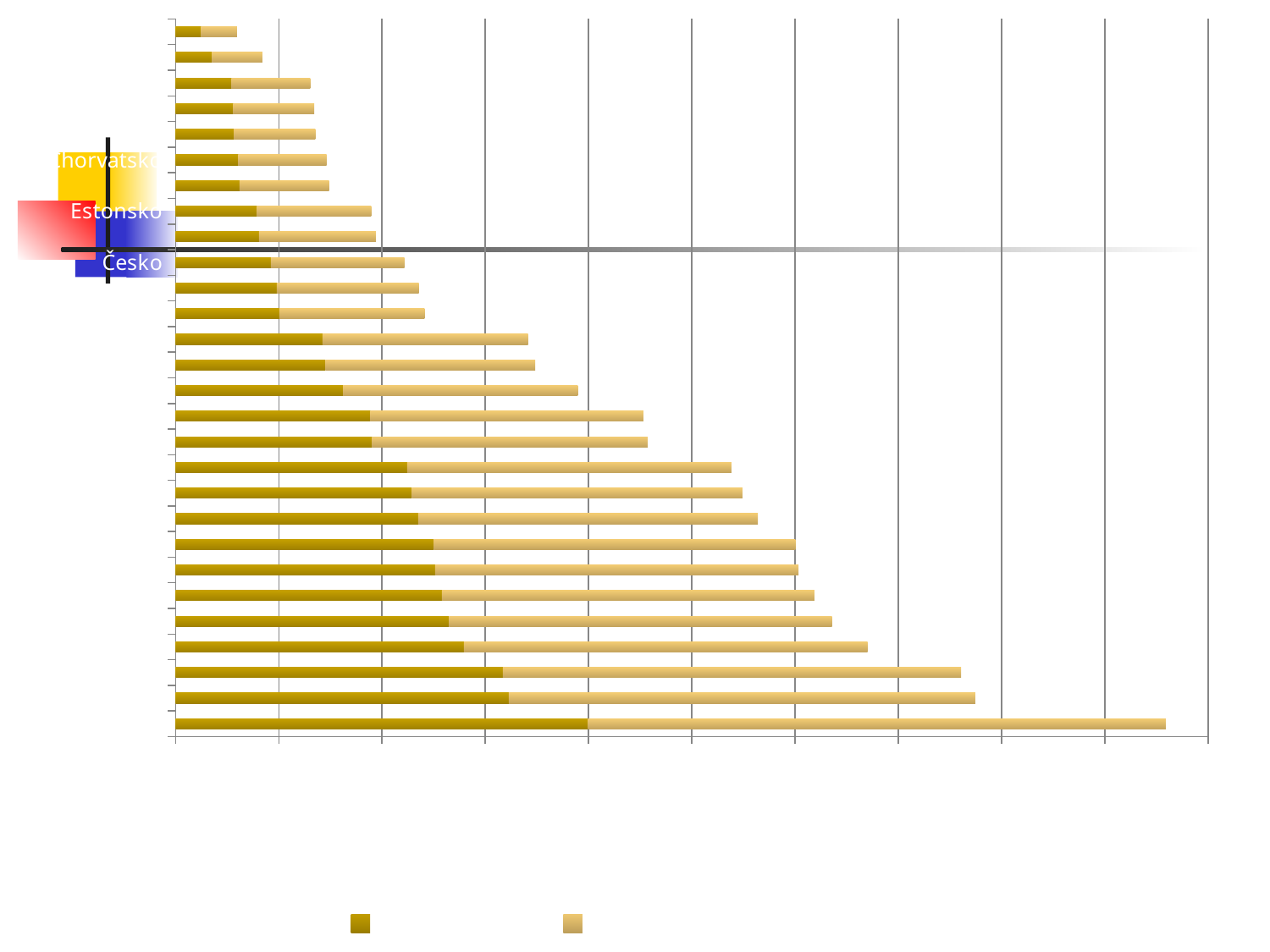
Which bar is the shortest: the top bar or the bottom bar? the top bar How many series does the legend below the chart show? 2 Do the bars get longer or shorter going from the top of the chart to the bottom? longer Are the bars in the chart drawn horizontally or vertically? horizontally Which bar is the longest: the top bar or the bottom bar? the bottom bar What kind of chart is shown on the slide? bar chart How many bars are plotted in the chart? 28 Are the bars stacked from two segments or drawn as single segments? stacked from two segments Is the bottom bar longer or shorter than the bar directly above it? longer In each bar, which segment is on the left: the darker gold one or the lighter tan one? the darker gold one